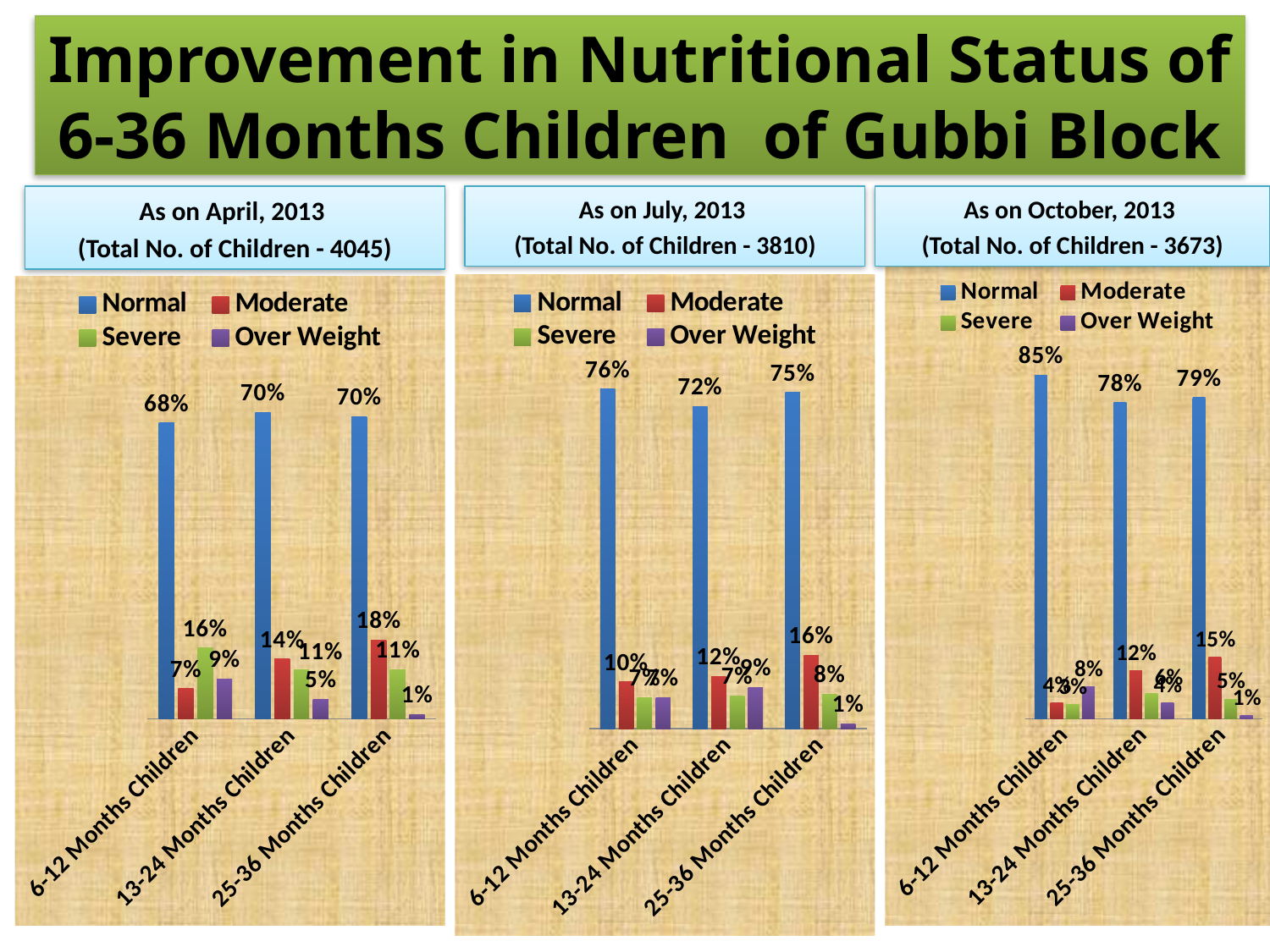
In the 'As on April, 2013' chart, which is larger for 6-12 Months Children: the Severe value or the Moderate value? Severe In the 'As on October, 2013' chart, what is the difference between the Normal values for 6-12 Months Children and 13-24 Months Children? 7% In the 'As on October, 2013' chart, what is the Normal value for 6-12 Months Children? 85% What type of chart is the 'As on April, 2013' chart? Bar chart In the 'As on April, 2013' chart, what is the Normal value for 6-12 Months Children? 68% In the 'As on July, 2013' chart, which category has the lowest Normal value? 13-24 Months Children According to the header above the 'As on October, 2013' chart, what is the total number of children? 3673 In the 'As on July, 2013' chart, what is the Moderate value for 25-36 Months Children? 16% In the 'As on July, 2013' chart, what is the Over Weight value for 13-24 Months Children? 9% In the 'As on July, 2013' chart, how many categories are shown on the x axis? 3 In the 'As on October, 2013' chart, how many series does the legend list? 4 In the 'As on April, 2013' chart, which category has the highest Moderate value? 25-36 Months Children